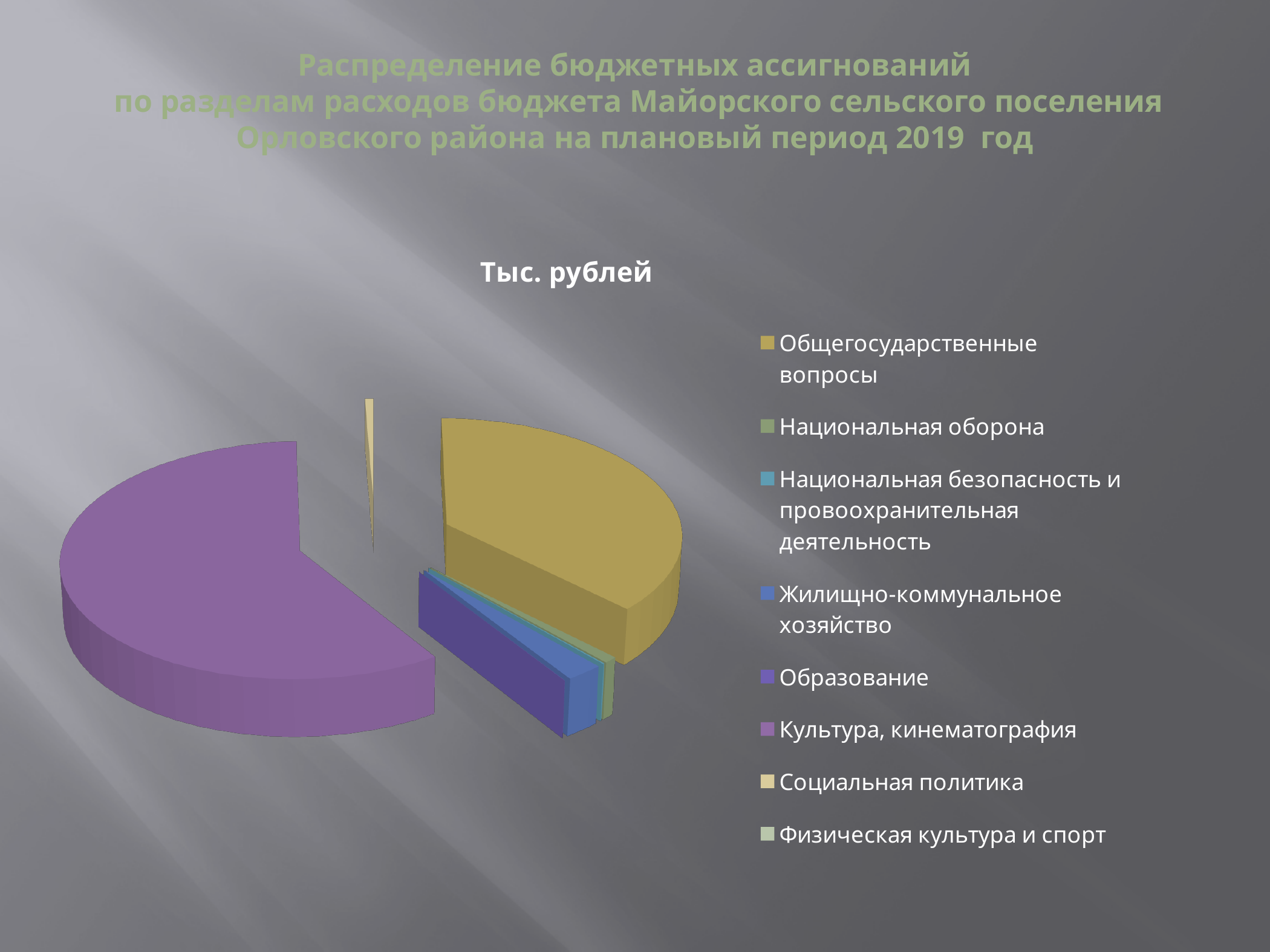
Which slice is larger: Культура, кинематография or Общегосударственные вопросы? Культура, кинематография Which slice is larger: Общегосударственные вопросы or Образование? Общегосударственные вопросы What kind of chart is shown on the slide? Pie chart How many categories does the legend of the pie chart list? 8 What colour is the slice for Культура, кинематография in the pie chart? Purple Which category has the largest slice in the pie chart? Культура, кинематография What is the title shown above the pie chart? Тыс. рублей Which slice is larger: Культура, кинематография or Жилищно-коммунальное хозяйство? Культура, кинематография